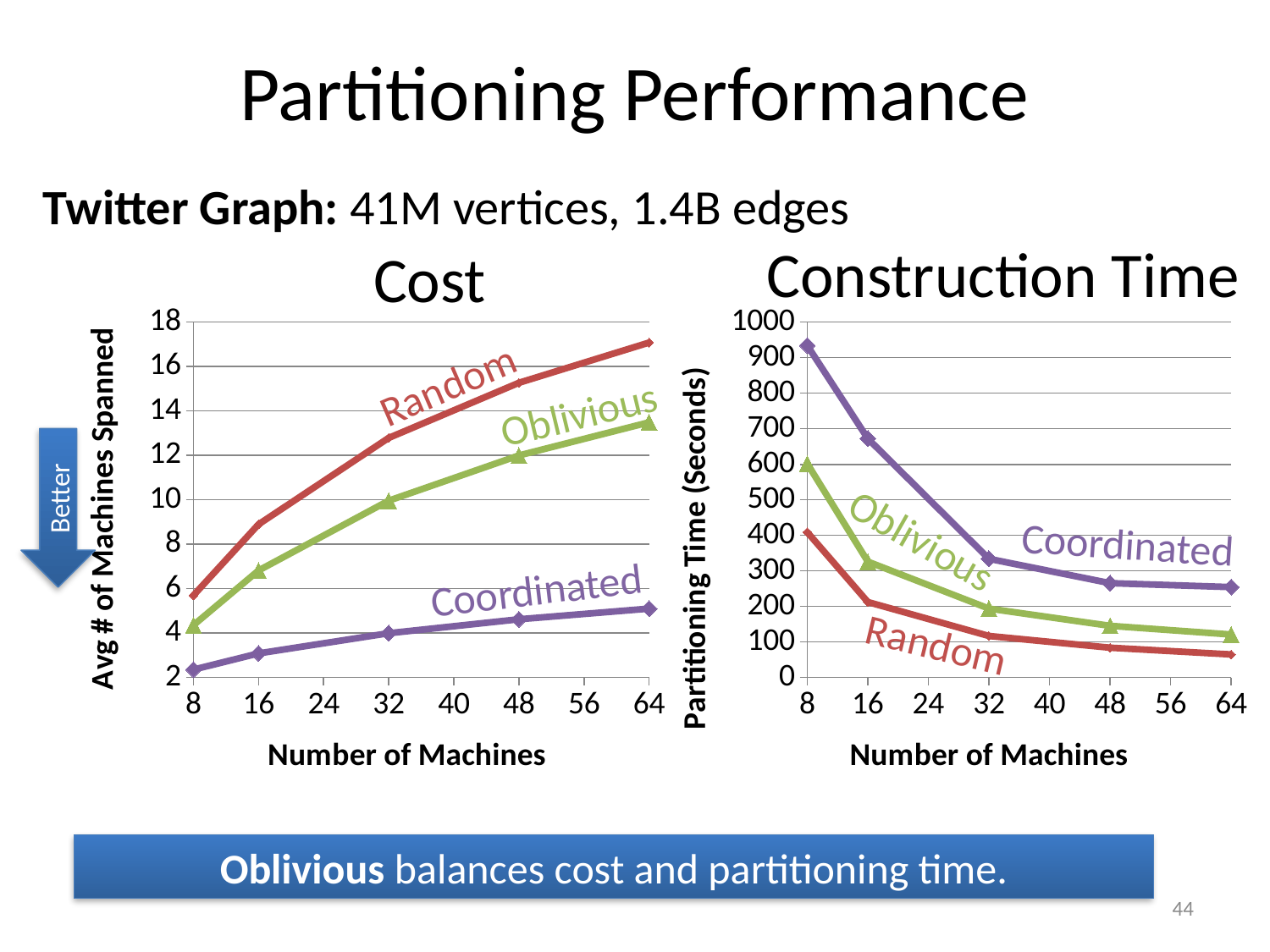
In the Cost chart, is the value for Coordinated at 8 machines greater or less than 4? less In the Cost chart, is the value for Random at 64 machines greater or less than 16? greater In the Cost chart, which series has the lowest value at 64 machines? Coordinated In the Construction Time chart, is the value for Coordinated at 8 machines greater or less than 800? greater In the Construction Time chart, which series has the highest value at 8 machines? Coordinated In the Construction Time chart, which series has the lowest value at 64 machines? Random In the Cost chart, which series has the highest value at 64 machines? Random In the Construction Time chart, does the Coordinated series rise or fall as the number of machines increases? fall In the Construction Time chart, what is the y-axis title? Partitioning Time (Seconds) What kind of chart is the Cost chart? line chart In the Cost chart, does the Random series rise or fall as the number of machines increases? rise